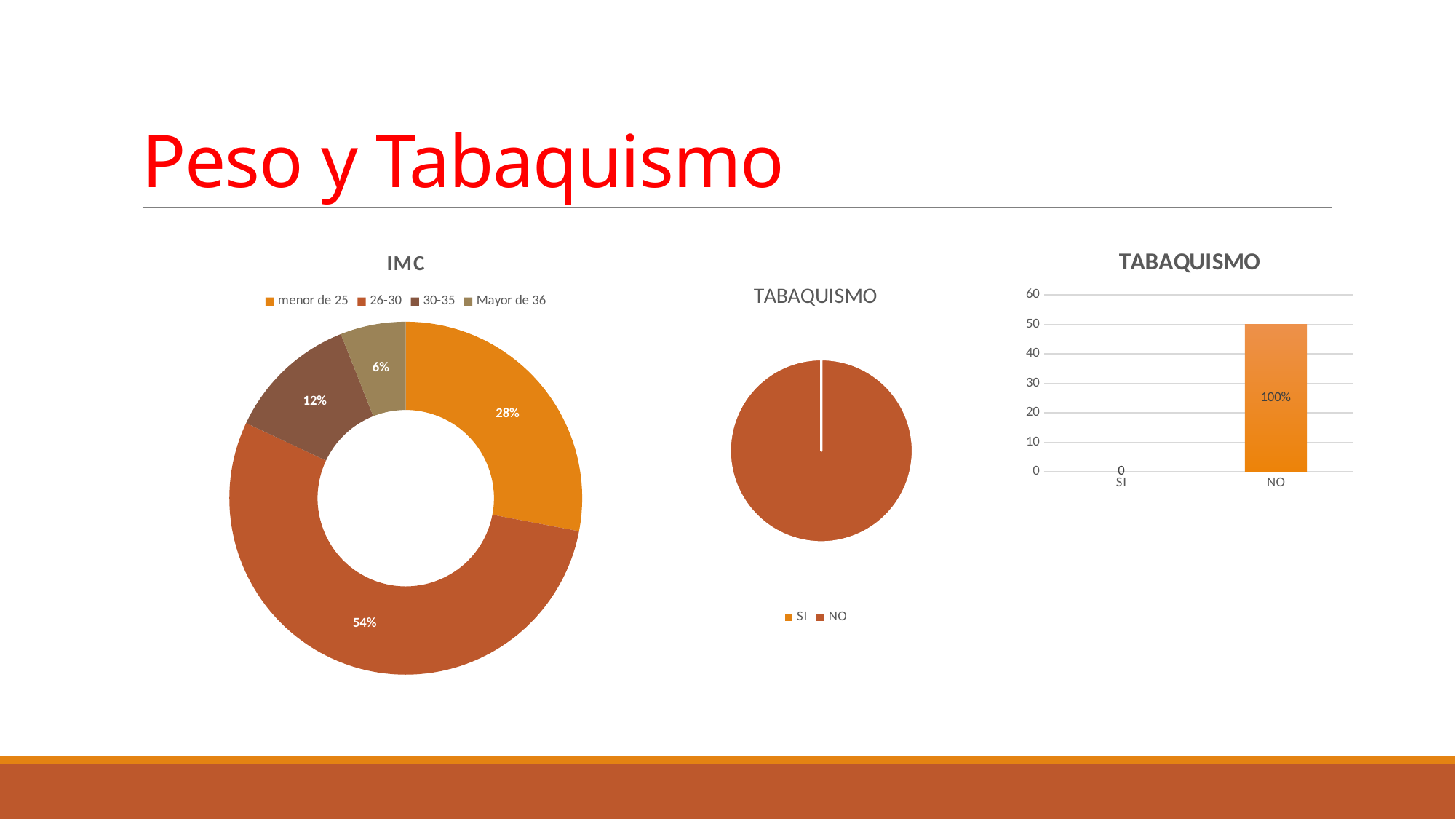
In the IMC chart, what is the difference between the shares of menor de 25 and 30-35? 16% How many entries does the legend of the TABAQUISMO pie chart in the middle list? 2 In the IMC chart, what percentage is shown for the 26-30 category? 54% In the IMC chart, which category has the largest share? 26-30 How many categories does the IMC chart show? 4 In the IMC chart, what percentage is shown for the Mayor de 36 category? 6% What kind of chart is the IMC chart? doughnut chart In the TABAQUISMO bar chart on the right, is the bar for NO greater or less than 40 on the axis? greater In the TABAQUISMO bar chart on the right, what data label is shown on the NO bar? 100% In the TABAQUISMO bar chart on the right, what value is shown for SI? 0 In the IMC chart, which is larger: the share for menor de 25 or the share for 30-35? menor de 25 In the IMC chart, which category has the smallest share? Mayor de 36